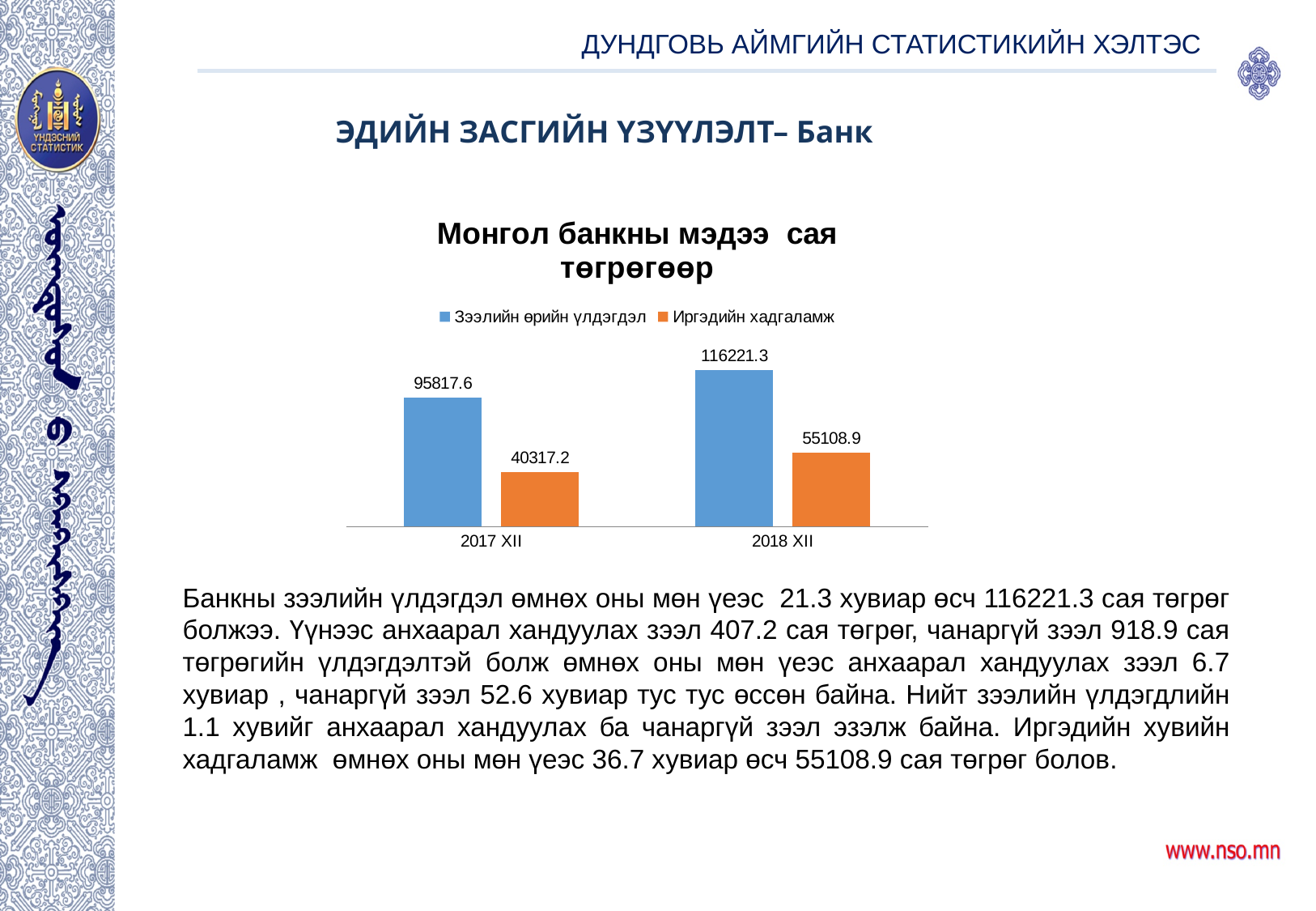
How many series does the chart legend list? 2 What type of chart is shown on the slide? Bar chart Which period has the lowest value for Иргэдийн хадгаламж? 2017 XII Which is larger in 2017 XII: Зээлийн өрийн үлдэгдэл or Иргэдийн хадгаламж? Зээлийн өрийн үлдэгдэл What is the value of Зээлийн өрийн үлдэгдэл for 2017 XII? 95817.6 What is the value of Зээлийн өрийн үлдэгдэл for 2018 XII? 116221.3 By how much did Зээлийн өрийн үлдэгдэл increase from 2017 XII to 2018 XII? 20403.7 What is the difference between Зээлийн өрийн үлдэгдэл and Иргэдийн хадгаламж in 2018 XII? 61112.4 Which period has the highest value for Зээлийн өрийн үлдэгдэл? 2018 XII How many periods are shown on the x axis of the chart? 2 What is the value of Иргэдийн хадгаламж for 2017 XII? 40317.2 What is the value of Иргэдийн хадгаламж for 2018 XII? 55108.9